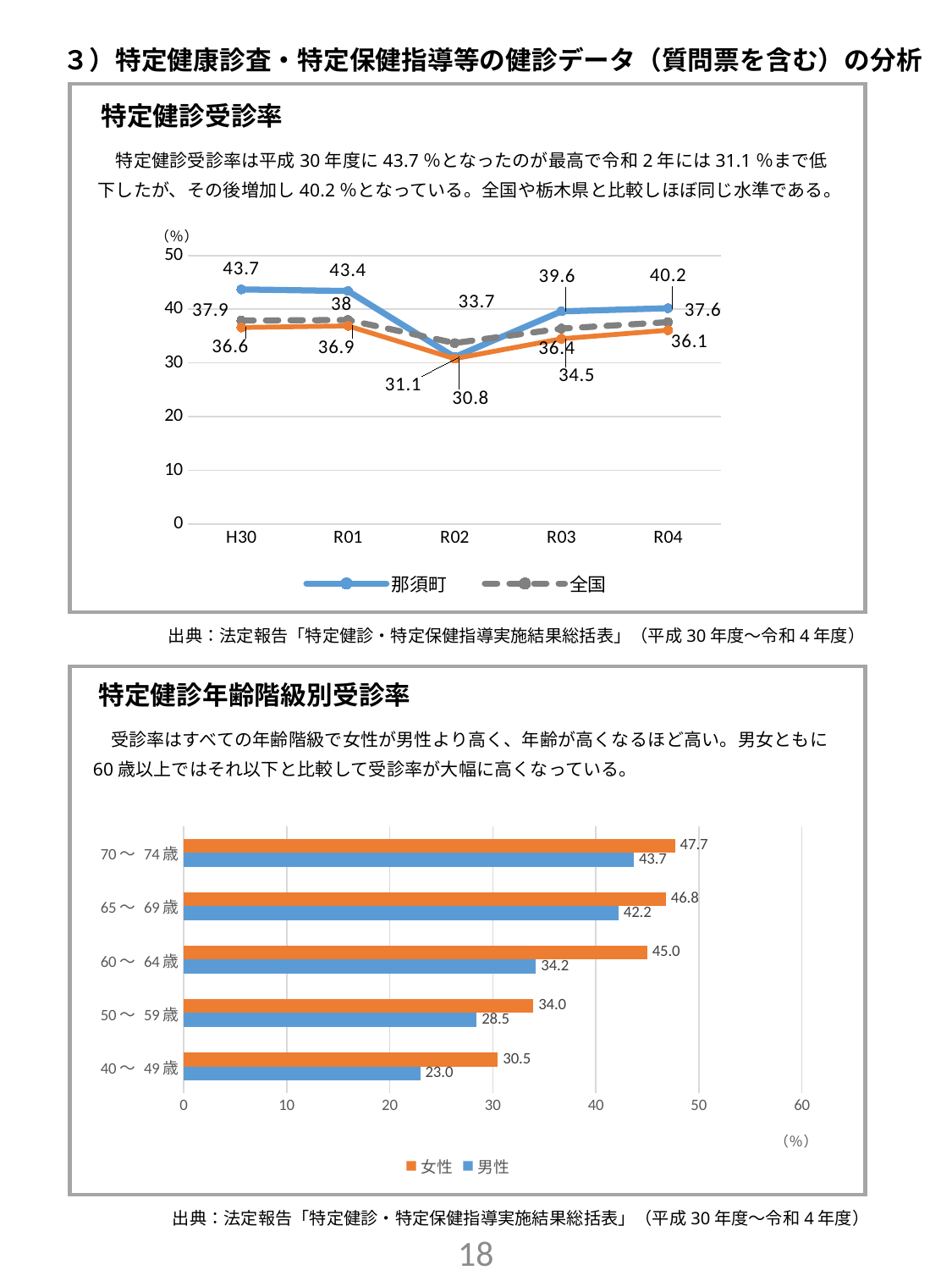
In the 特定健診受診率 line chart, in which year is the 那須町 value lowest? R02 In the 特定健診受診率 line chart, how many years are shown on the x axis? 5 In the 特定健診受診率 line chart, what is the value for 那須町 in H30? 43.7 In the 特定健診受診率 line chart, what is the difference between 那須町 and 全国 in H30? 5.8 In the 特定健診年齢階級別受診率 bar chart, what is the difference between 女性 and 男性 in the 60～64歳 group? 10.8 In the 特定健診受診率 line chart, what is the value for 全国 in R04? 37.6 In the 特定健診受診率 line chart, what is the value for 那須町 in R02? 31.1 In the 特定健診年齢階級別受診率 bar chart, what is the value for 男性 in the 40～49歳 group? 23.0 In the 特定健診年齢階級別受診率 bar chart, what is the value for 女性 in the 60～64歳 group? 45.0 In the 特定健診年齢階級別受診率 bar chart, which age group has the highest 女性 value? 70～74歳 In the 特定健診受診率 line chart, how many entries does the legend list? 2 What kind of chart is the 特定健診年齢階級別受診率 chart? bar chart